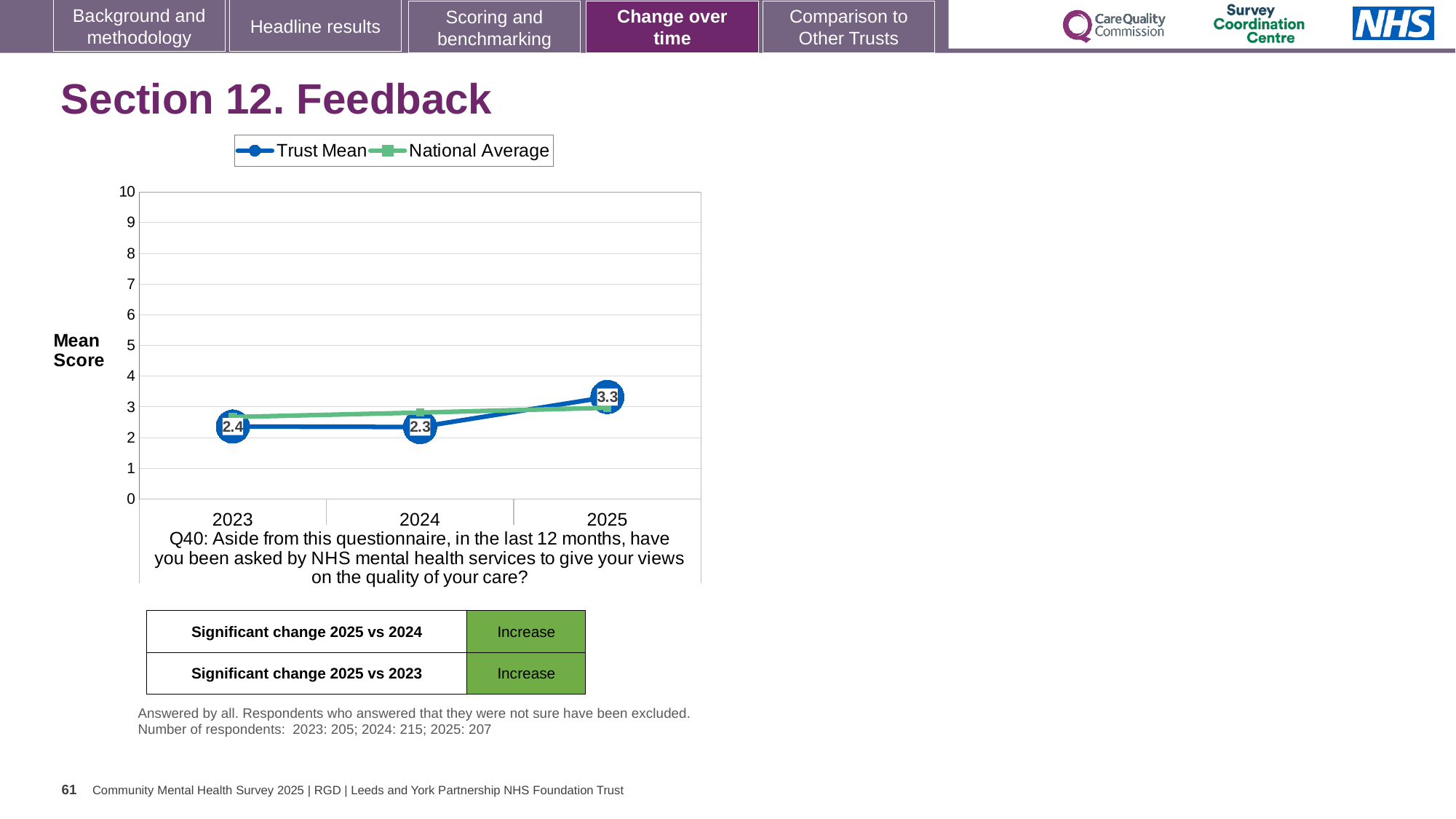
In 2025, which is higher: the Trust Mean or the National Average? Trust Mean How many years are shown on the x axis? 3 What is the Trust Mean score for 2023? 2.4 In which year is the Trust Mean highest? 2025 How many series does the legend list? 2 What is the Trust Mean score for 2025? 3.3 Is the National Average value for 2023 greater or less than 3? less By how much did the Trust Mean change from 2023 to 2025? 0.9 What is the Trust Mean score for 2024? 2.3 What kind of chart is shown on the slide? line chart In which year is the Trust Mean lowest? 2024 By how much did the Trust Mean change from 2024 to 2025? 1.0